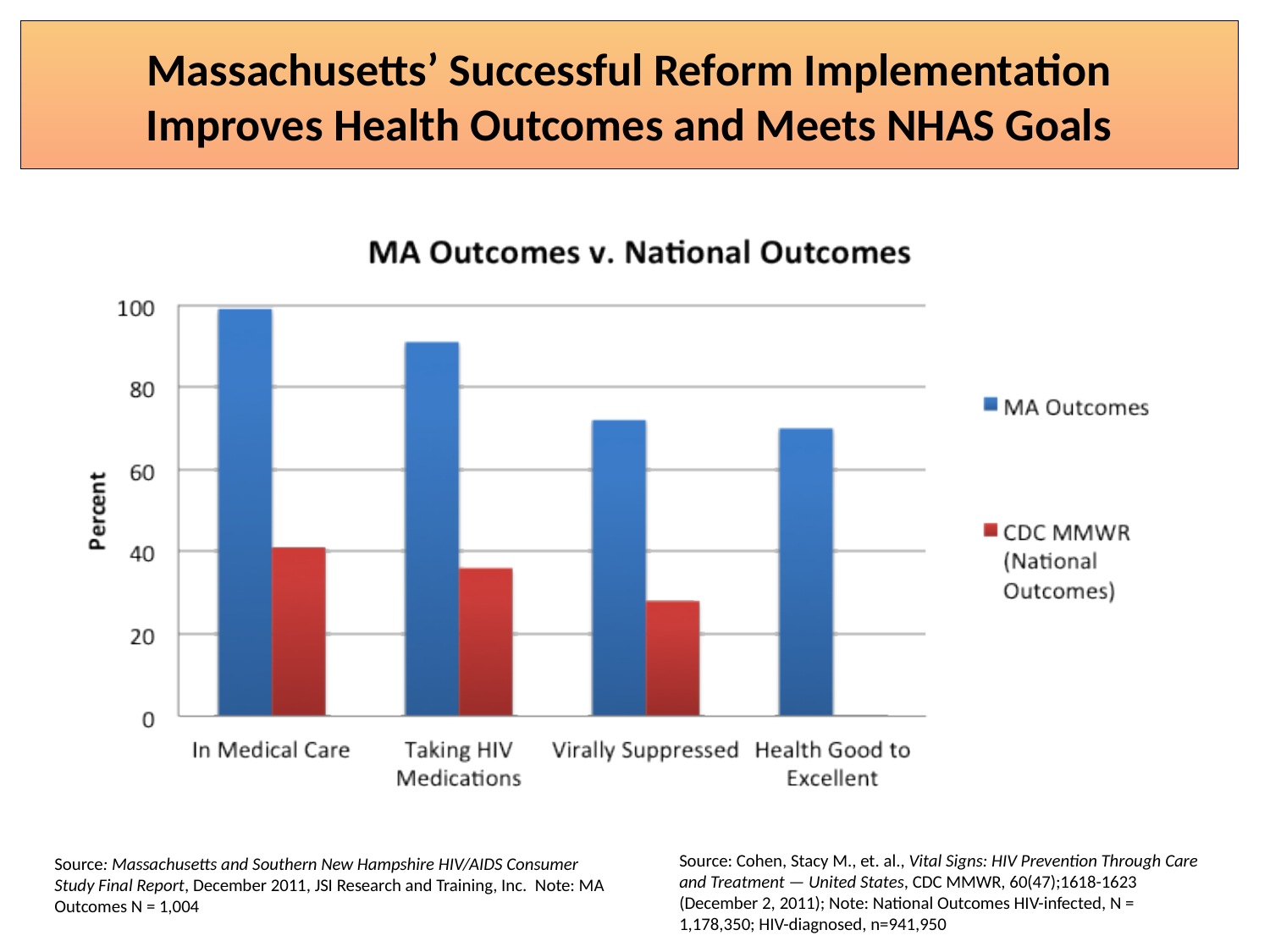
Which category has the lowest CDC MMWR (National Outcomes) value among those with a bar? Virally Suppressed What type of chart is shown on the slide? Bar chart What is the title of the chart? MA Outcomes v. National Outcomes Which category has the highest MA Outcomes value? In Medical Care Is the CDC MMWR (National Outcomes) value for Taking HIV Medications greater or less than 40? less Is the MA Outcomes value for In Medical Care greater or less than 80? greater Do the MA Outcomes values rise or fall moving from left to right across the categories? fall What is the label on the y axis of the chart? Percent For In Medical Care, which is larger: MA Outcomes or CDC MMWR (National Outcomes)? MA Outcomes How many categories are shown on the x axis of the chart? 4 Is the MA Outcomes value for Virally Suppressed greater or less than 60? greater How many series does the chart legend list? 2